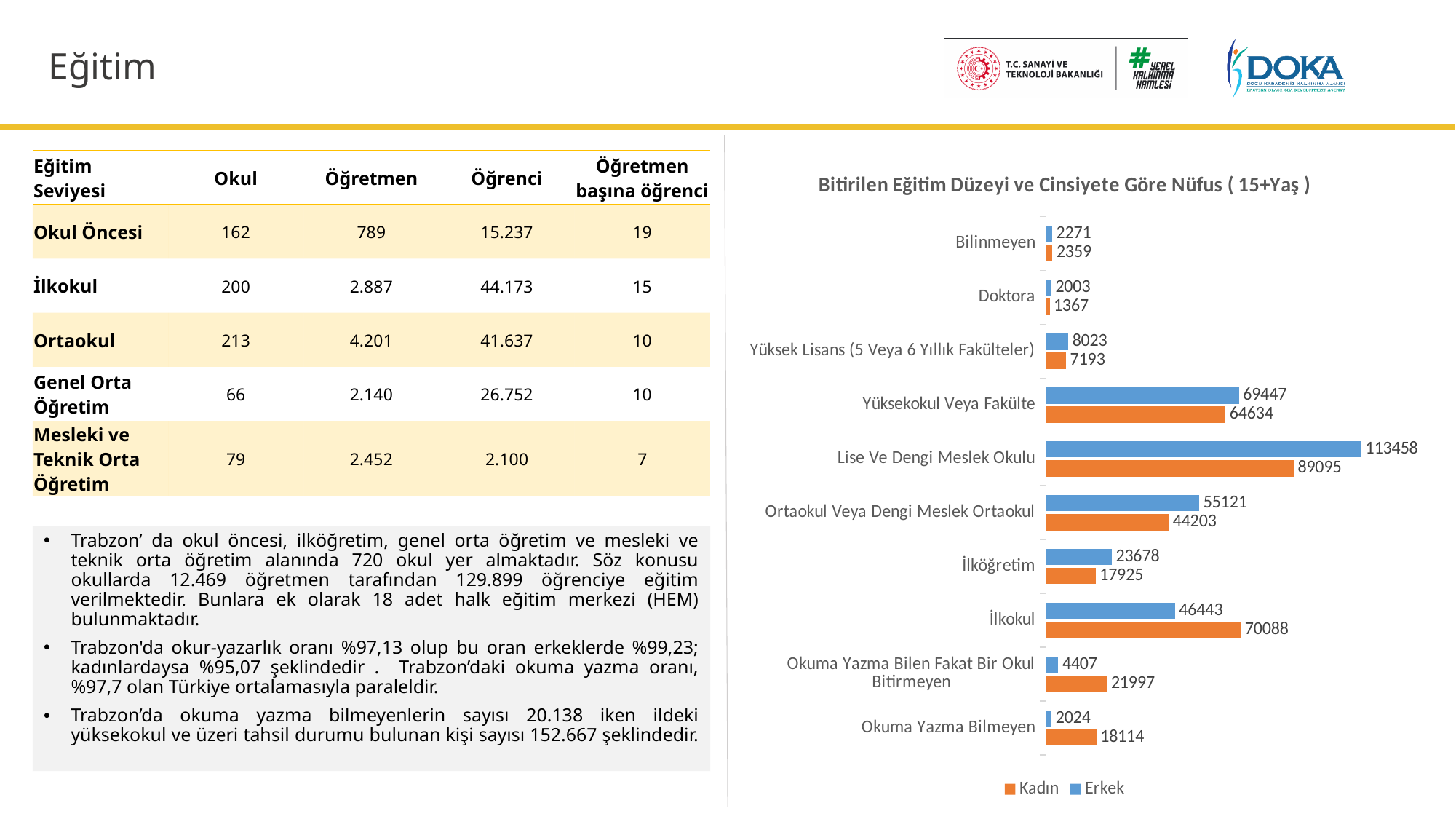
What is the Erkek value for Lise Ve Dengi Meslek Okulu? 113458 Which category has the highest Erkek value? Lise Ve Dengi Meslek Okulu Which category has the lowest Kadın value? Doktora What is the difference between the Erkek and Kadın values for Lise Ve Dengi Meslek Okulu? 24363 What is the Kadın value for Okuma Yazma Bilmeyen? 18114 What is the title of the chart? Bitirilen Eğitim Düzeyi ve Cinsiyete Göre Nüfus ( 15+Yaş ) What is the Kadın value for İlkokul? 70088 How many education-level categories are shown in the chart? 10 For İlkokul, which is larger, the Kadın value or the Erkek value? Kadın What type of chart is shown on the slide? Bar chart How many series does the chart legend list? 2 What is the difference between the Kadın and Erkek values for Okuma Yazma Bilen Fakat Bir Okul Bitirmeyen? 17590